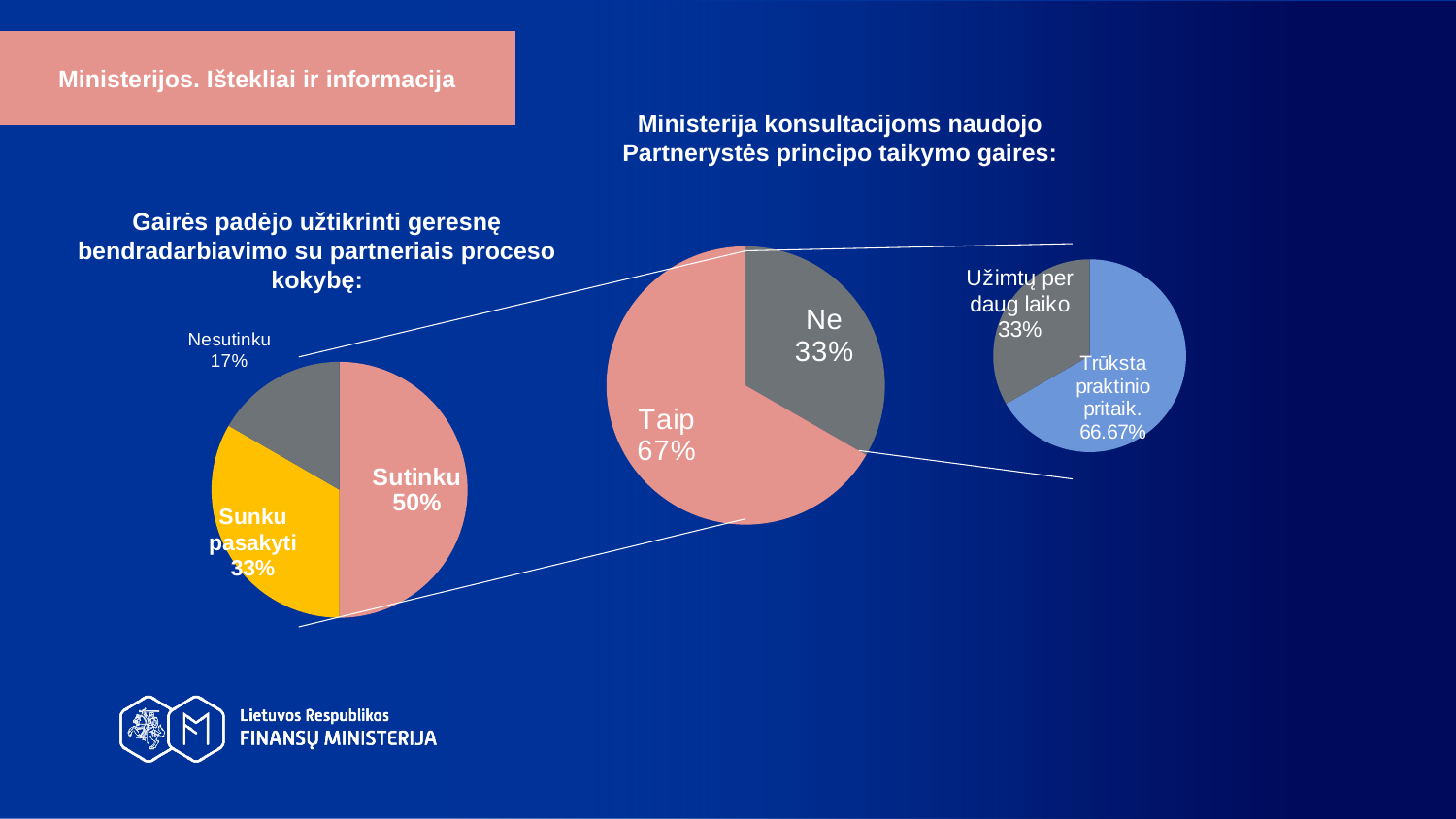
In the pie chart titled "Gairės padėjo užtikrinti geresnę bendradarbiavimo su partneriais proceso kokybę", how many slices are there? 3 In the pie chart titled "Ministerija konsultacijoms naudojo Partnerystės principo taikymo gaires", what share is labelled "Taip"? 67% What type of chart is used for the chart titled "Ministerija konsultacijoms naudojo Partnerystės principo taikymo gaires"? Pie chart In the pie chart titled "Gairės padėjo užtikrinti geresnę bendradarbiavimo su partneriais proceso kokybę", which slice is the largest? Sutinku In the pie chart titled "Ministerija konsultacijoms naudojo Partnerystės principo taikymo gaires", what share is labelled "Ne"? 33% In the pie chart titled "Gairės padėjo užtikrinti geresnę bendradarbiavimo su partneriais proceso kokybę", what share is labelled "Nesutinku"? 17% In the pie chart titled "Gairės padėjo užtikrinti geresnę bendradarbiavimo su partneriais proceso kokybę", which slice is the smallest? Nesutinku In the pie chart titled "Ministerija konsultacijoms naudojo Partnerystės principo taikymo gaires", which is larger, "Taip" or "Ne"? Taip In the pie chart titled "Gairės padėjo užtikrinti geresnę bendradarbiavimo su partneriais proceso kokybę", what is the difference between the "Sutinku" and "Nesutinku" shares? 33% In the pie chart titled "Gairės padėjo užtikrinti geresnę bendradarbiavimo su partneriais proceso kokybę", what share is labelled "Sutinku"? 50% In the small pie chart on the right of the slide, what share is labelled "Trūksta praktinio pritaik."? 66.67% In the pie chart titled "Gairės padėjo užtikrinti geresnę bendradarbiavimo su partneriais proceso kokybę", what share is labelled "Sunku pasakyti"? 33%